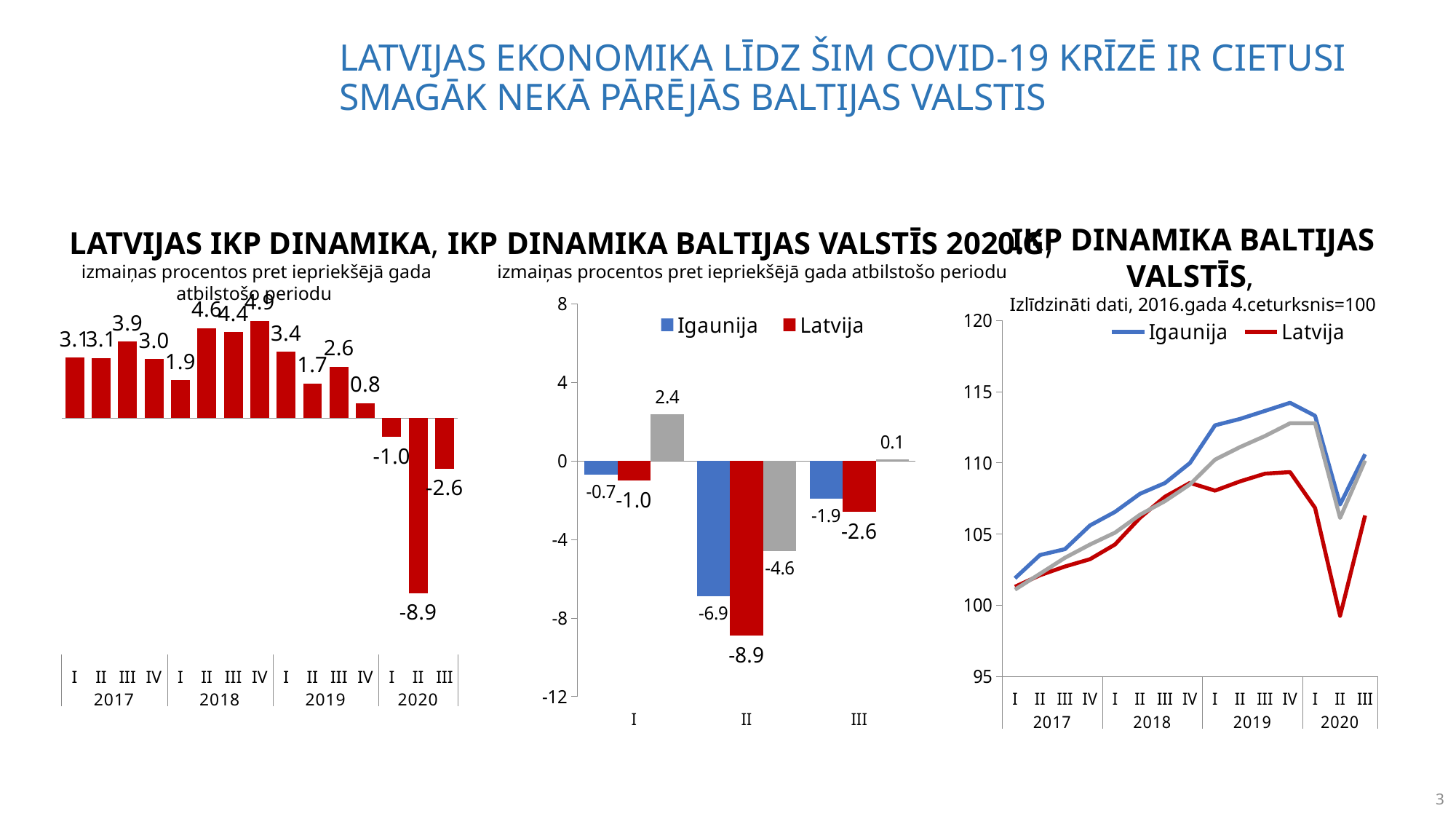
In the left chart 'LATVIJAS IKP DINAMIKA', how many bars are plotted? 15 In the right chart 'IKP DINAMIKA BALTIJAS VALSTĪS', is the value for Latvija in quarter II of 2020 greater or less than 100? less In the left chart 'LATVIJAS IKP DINAMIKA', which quarter has the lowest value? II 2020 In the middle chart 'IKP DINAMIKA BALTIJAS VALSTĪS 2020.G', what is the difference between the Igaunija and Latvija values in quarter II? 2.0 In the right chart 'IKP DINAMIKA BALTIJAS VALSTĪS', which series is higher in quarter IV of 2019, Igaunija or Latvija? Igaunija In the middle chart 'IKP DINAMIKA BALTIJAS VALSTĪS 2020.G', which is larger in quarter I, the value for Igaunija or for Latvija? Igaunija What kind of chart is the left chart 'LATVIJAS IKP DINAMIKA'? bar chart In the left chart 'LATVIJAS IKP DINAMIKA', what is the value for quarter II of 2020? -8.9 In the left chart 'LATVIJAS IKP DINAMIKA', which quarter has the highest value? IV 2018 In the middle chart 'IKP DINAMIKA BALTIJAS VALSTĪS 2020.G', what is the value for Latvija in quarter III? -2.6 In the middle chart 'IKP DINAMIKA BALTIJAS VALSTĪS 2020.G', what is the value for Igaunija in quarter II? -6.9 What kind of chart is the right chart 'IKP DINAMIKA BALTIJAS VALSTĪS'? line chart